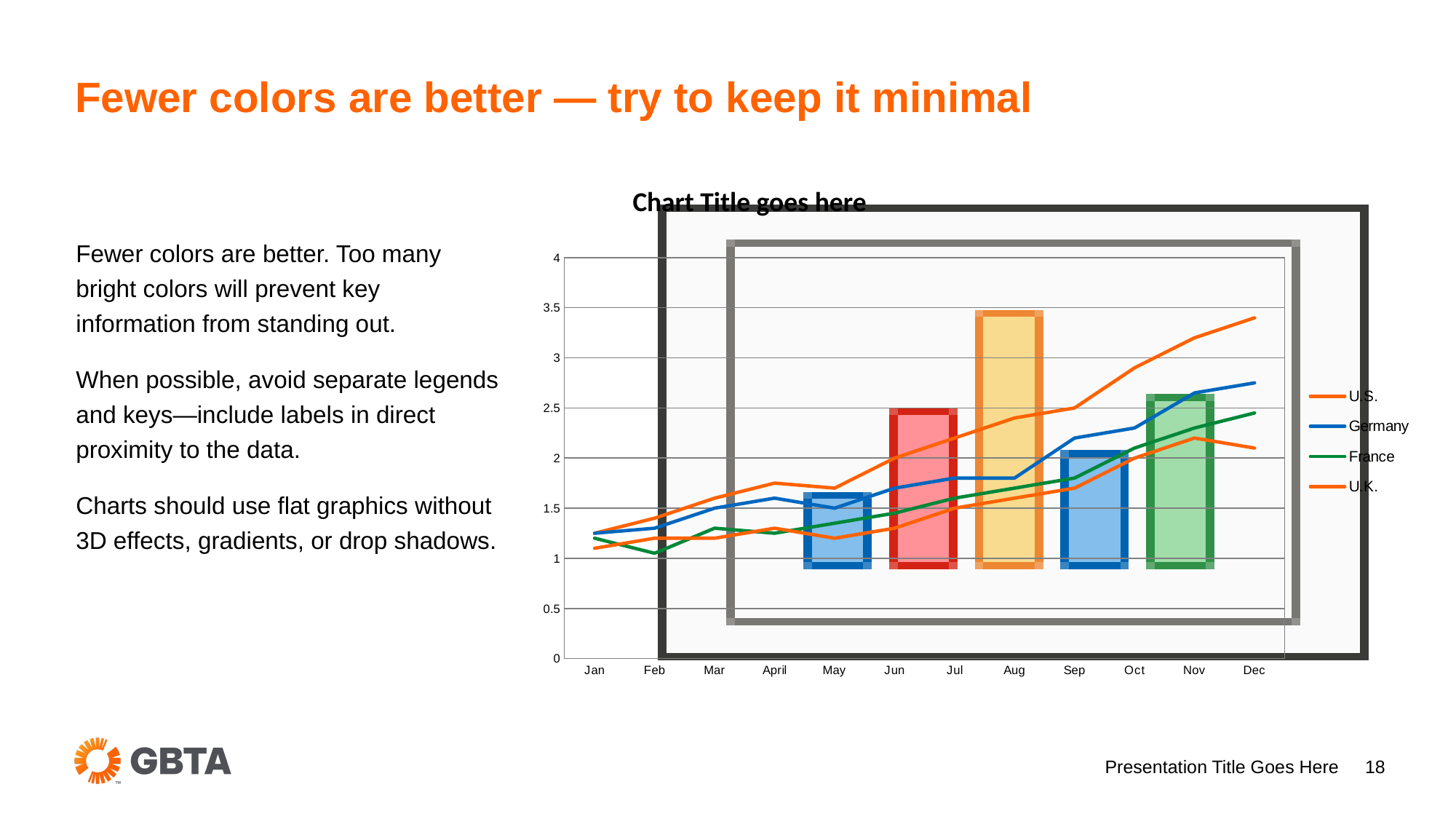
In Dec, which is larger: the value for Germany or the value for U.K.? Germany Is the value for Germany in Dec greater or less than 2.5? greater How many months are shown along the x axis of the chart? 12 Does the U.S. series generally rise or fall from Jan to Dec? rise Is the value for France in Jan greater or less than 1.5? less What is the title of the chart? Chart Title goes here Is the value for U.S. in Dec greater or less than 3? greater What kind of chart is shown on the slide? line chart How many series does the chart's legend list? 4 Which series are listed in the chart's legend? U.S., Germany, France, U.K. Which series has the highest value in Dec? U.S.